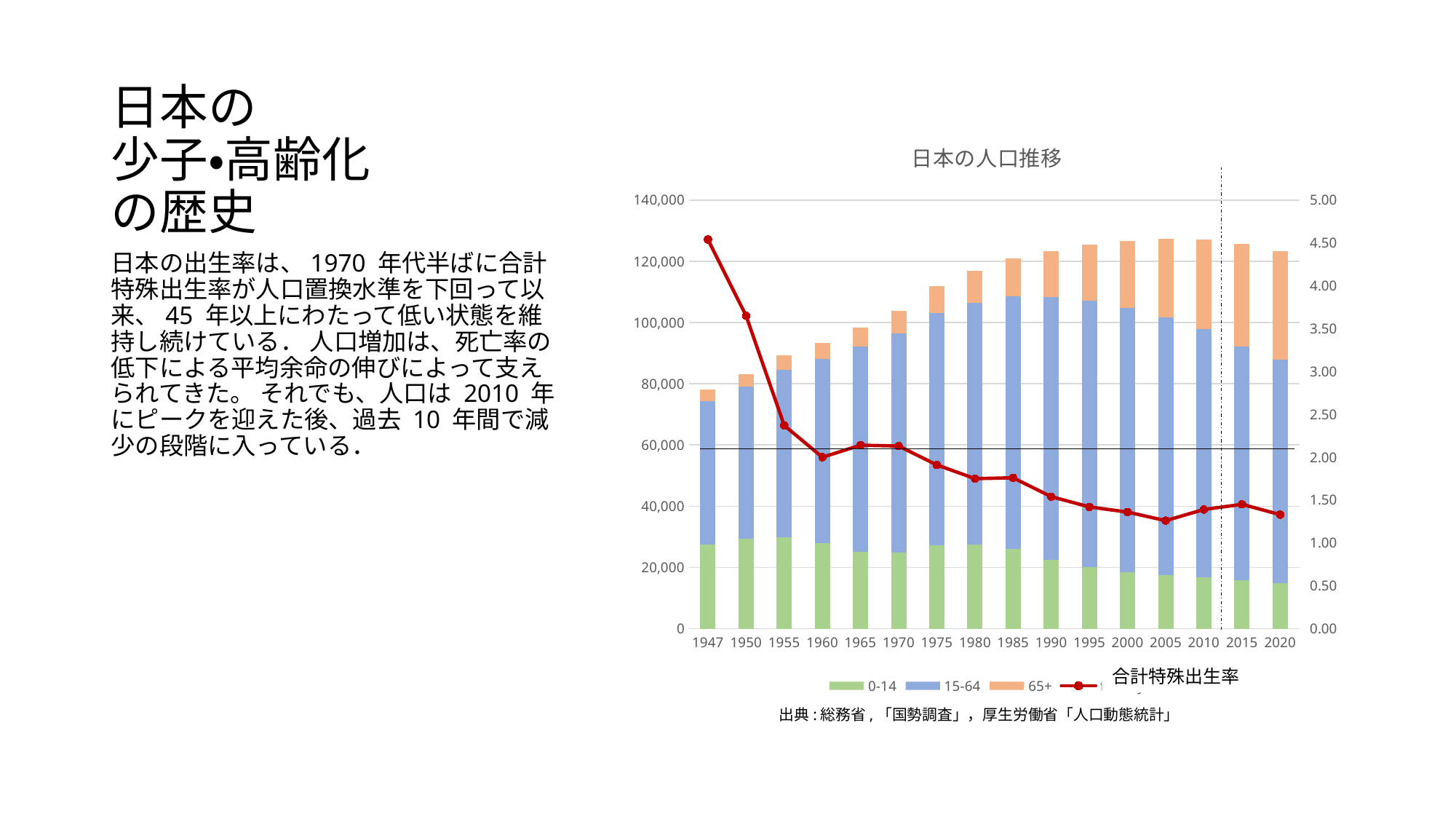
Is the total population bar for 1947 greater or less than 100,000? less In which year is the 合計特殊出生率 line at its lowest? 2005 Which year has the larger 合計特殊出生率 value, 1970 or 1990? 1970 Is the 合計特殊出生率 value for 2020 greater or less than 2.00? less What is the title of the chart? 日本の人口推移 Is the total population bar for 2020 greater or less than 120,000? greater In which year is the 合計特殊出生率 line at its highest? 1947 How many years are shown along the x axis of the chart? 16 How many series does the chart legend list? 4 What kind of chart is shown on the slide? A stacked bar chart combined with a line chart Does the 合計特殊出生率 line generally rise or fall from 1947 to 2020? fall